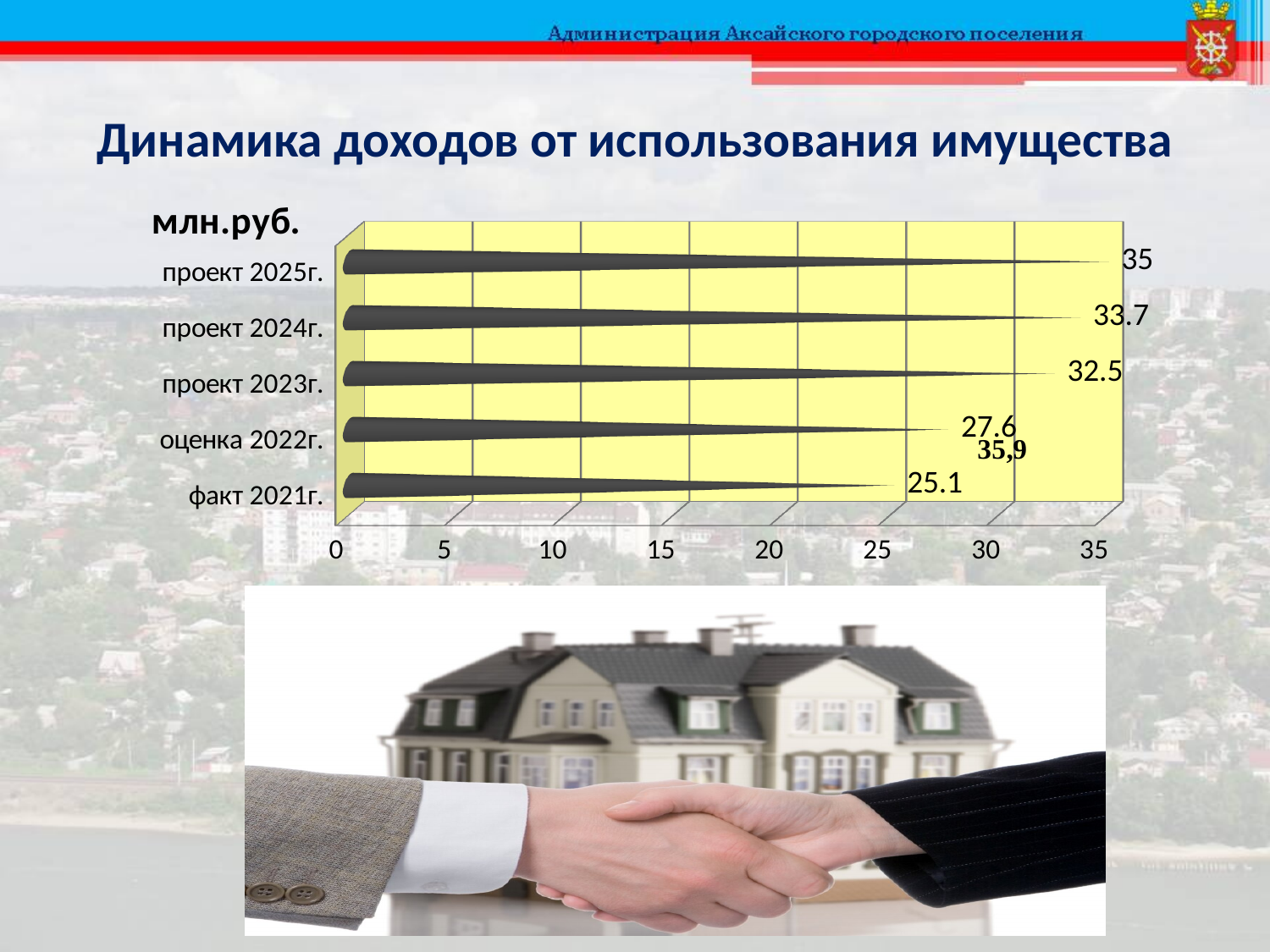
What kind of chart is shown on the slide? bar chart What is the value for факт 2021г.? 25.1 What is the value for проект 2023г.? 32.5 What is the difference between the values for проект 2025г. and факт 2021г.? 9.9 What is the title of the chart? Динамика доходов от использования имущества What is the difference between the values for проект 2024г. and проект 2023г.? 1.2 Which is larger, the value for оценка 2022г. or the value for проект 2023г.? проект 2023г. What is the value for проект 2024г.? 33.7 How many categories are shown in the chart? 5 Which category has the lowest value? факт 2021г. Which category has the highest value? проект 2025г. What is the value for проект 2025г.? 35